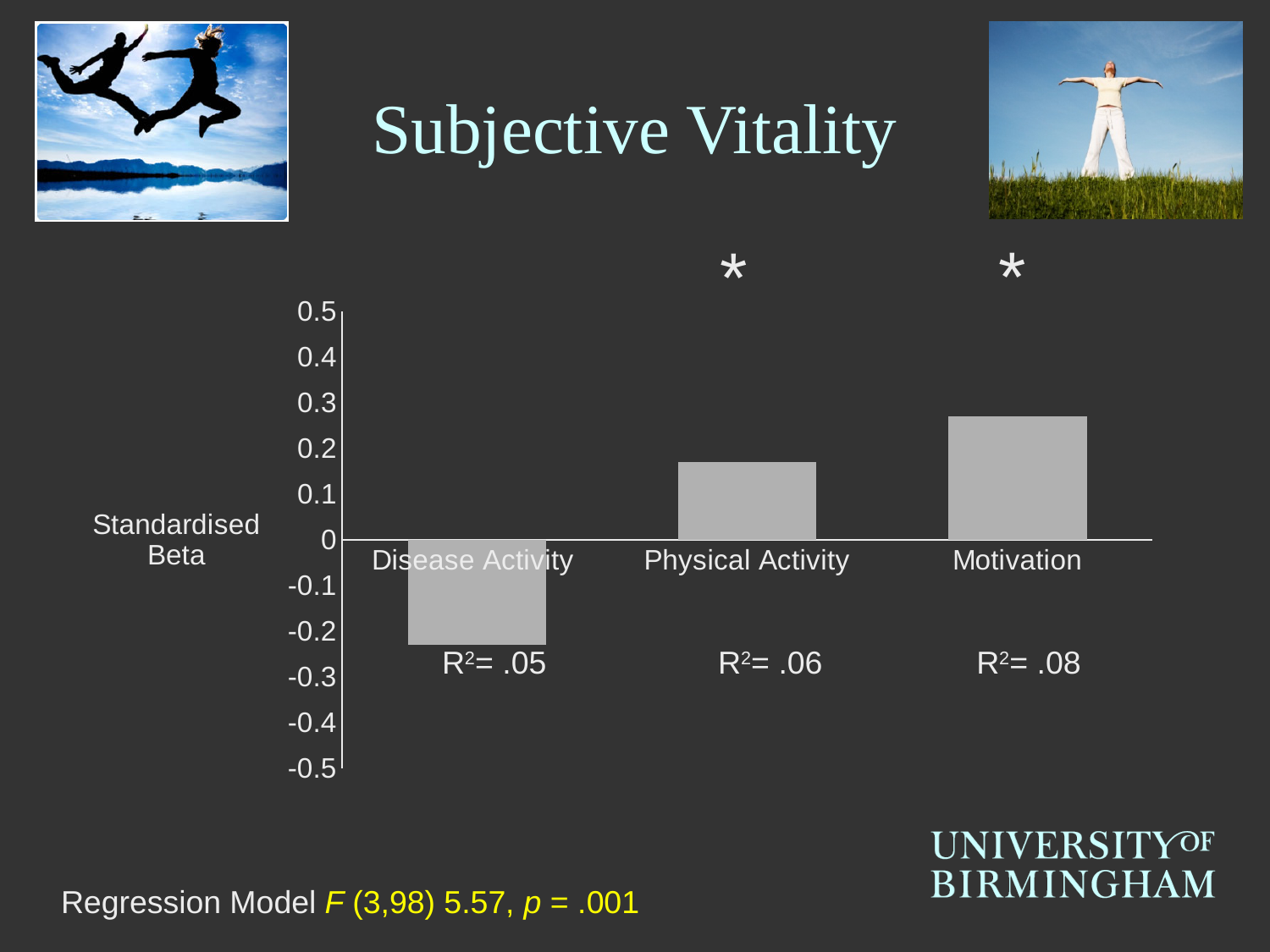
Is the value for Physical Activity greater or less than 0.1? greater Which category has the highest standardised beta? Motivation How many categories are plotted on the chart? 3 Is the value for Disease Activity greater or less than -0.1? less Which has the larger standardised beta, Physical Activity or Motivation? Motivation Is the value for Motivation greater or less than 0.3? less What kind of chart is shown on the slide? bar chart What is the label on the vertical axis of the chart? Standardised Beta Which category has the lowest standardised beta? Disease Activity